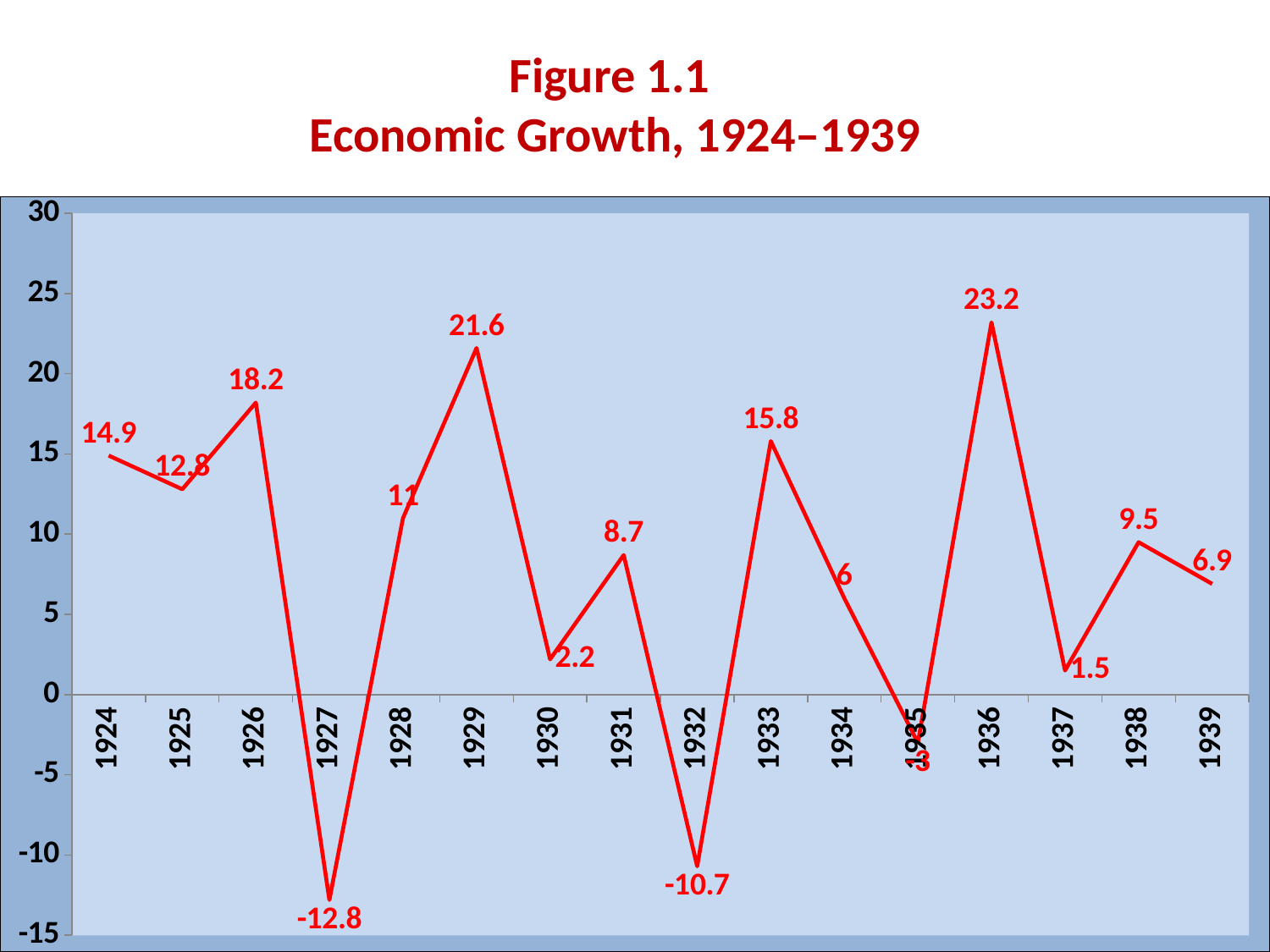
What is the economic growth value for 1932? -10.7 What is the economic growth value for 1929? 21.6 What is the economic growth value for 1936? 23.2 What is the economic growth value for 1927? -12.8 Which year has the highest economic growth value? 1936 How many years are plotted on the x axis? 16 What type of chart is shown in Figure 1.1? line chart Which year has a larger value, 1926 or 1933? 1926 Does the value rise or fall from 1937 to 1938? rise What is the difference between the values for 1936 and 1929? 1.6 Which year has the lowest economic growth value? 1927 What is the title of the chart? Figure 1.1 Economic Growth, 1924–1939